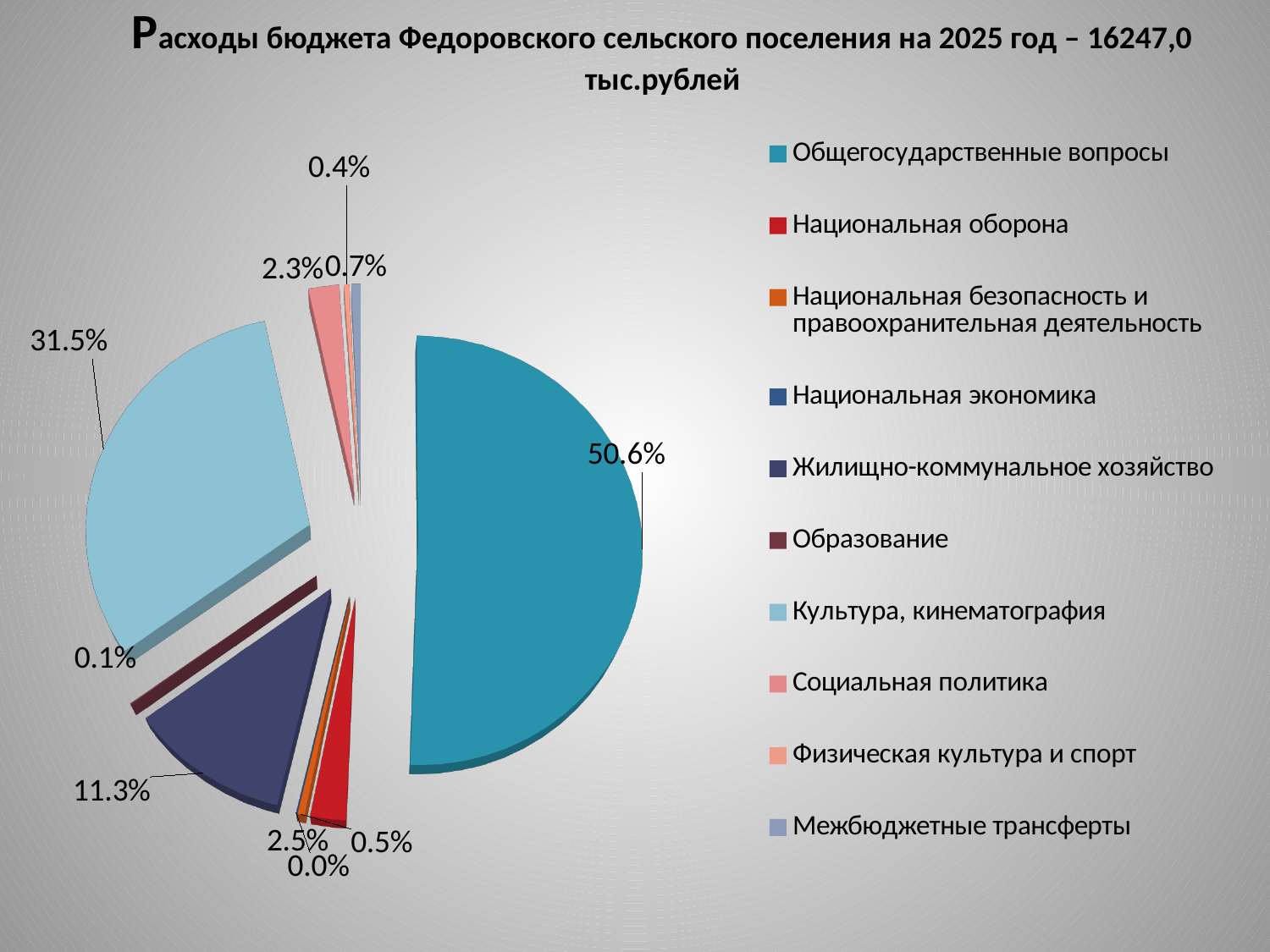
What kind of chart is shown on the slide? pie chart What share of the budget expenditure goes to Жилищно-коммунальное хозяйство? 11.3% Which is larger: the share for Социальная политика or the share for Жилищно-коммунальное хозяйство? Жилищно-коммунальное хозяйство What total budget expenditure amount is stated in the chart title? 16247,0 тыс.рублей What share of the budget expenditure goes to Социальная политика? 2.3% What is the difference in percentage points between Общегосударственные вопросы and Культура, кинематография? 19.1 What share of the budget expenditure goes to Общегосударственные вопросы? 50.6% Which is larger: the share for Культура, кинематография or the share for Жилищно-коммунальное хозяйство? Культура, кинематография What colour is the slice for Общегосударственные вопросы? teal What share of the budget expenditure goes to Культура, кинематография? 31.5% Which category has the largest share of the pie? Общегосударственные вопросы How many categories does the legend of the pie chart list? 10